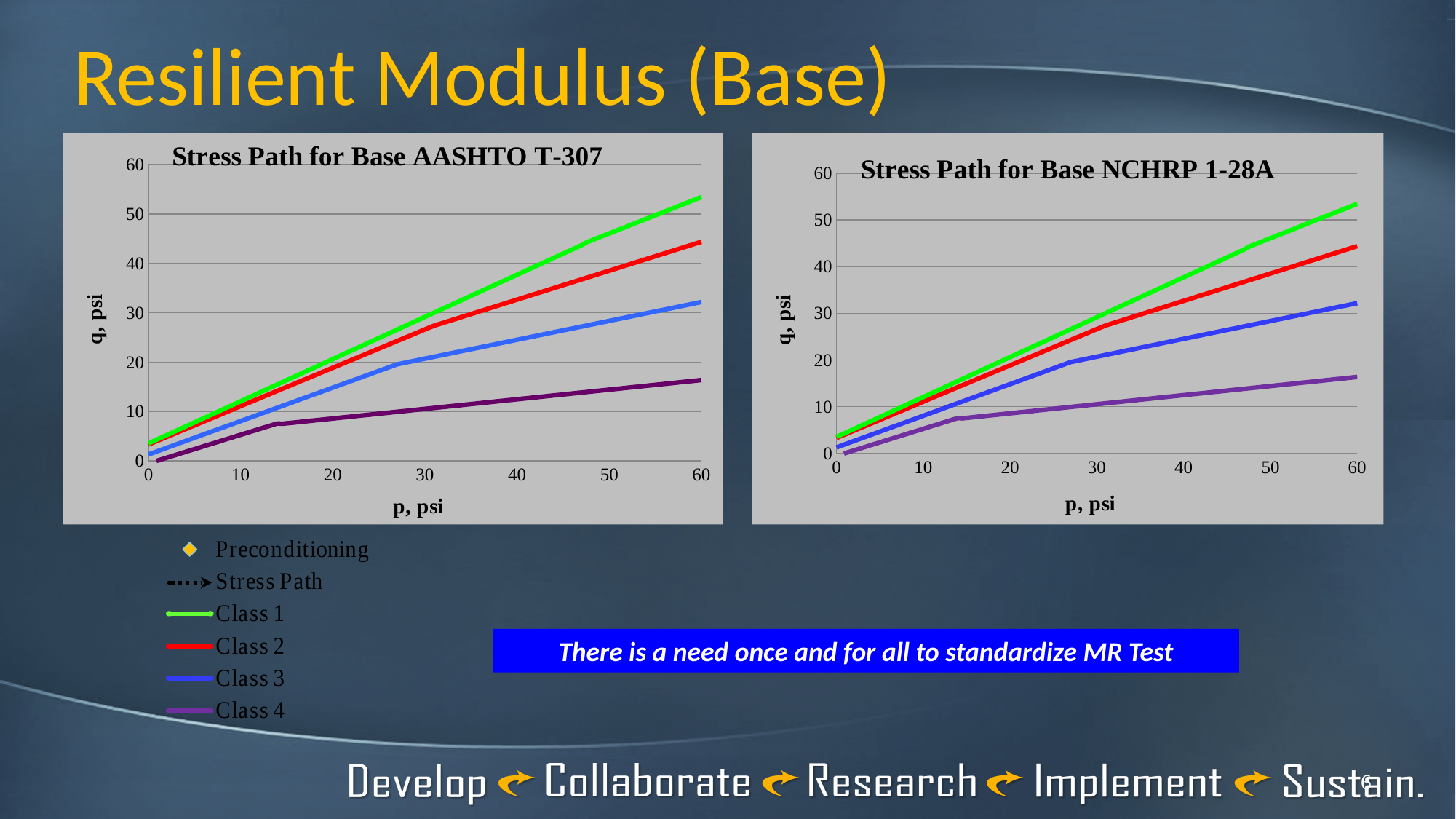
In the 'Stress Path for Base AASHTO T-307' chart, which is larger at p = 60 psi, Class 2 or Class 3? Class 2 In the 'Stress Path for Base NCHRP 1-28A' chart, is the Class 2 value at p = 60 psi greater or less than 50? less In the 'Stress Path for Base AASHTO T-307' chart, which class has the lowest q value at p = 60 psi? Class 4 In the 'Stress Path for Base NCHRP 1-28A' chart, do the q values rise or fall as p increases? rise In the 'Stress Path for Base NCHRP 1-28A' chart, which class has the highest q value at p = 60 psi? Class 1 What is the y-axis title of the 'Stress Path for Base NCHRP 1-28A' chart? q, psi How many class lines are plotted in the 'Stress Path for Base AASHTO T-307' chart? 4 In the 'Stress Path for Base AASHTO T-307' chart, is the Class 1 value at p = 60 psi greater or less than 50? greater In the 'Stress Path for Base NCHRP 1-28A' chart, is the Class 4 value at p = 60 psi greater or less than 20? less What kind of chart is the 'Stress Path for Base AASHTO T-307' chart? line chart How many entries does the legend below the charts list? 6